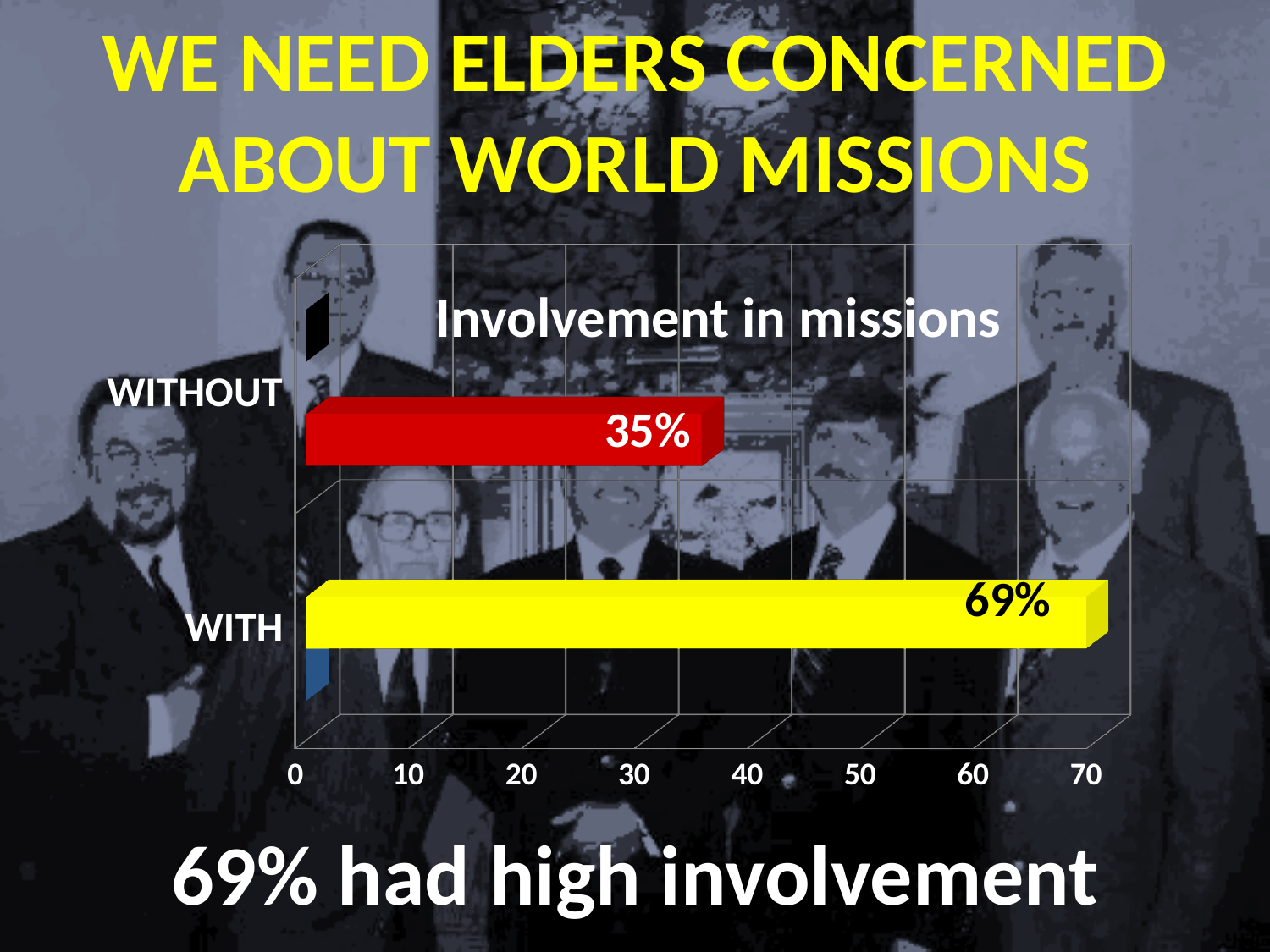
How many categories are shown in the Involvement in missions chart? 2 What kind of chart is the Involvement in missions chart? bar chart What is the value for WITH in the Involvement in missions chart? 69% Which category has the lowest value in the Involvement in missions chart? WITHOUT Is the value for WITHOUT greater or less than 40 in the Involvement in missions chart? less Which category has the highest value in the Involvement in missions chart? WITH What colour is the WITH bar in the Involvement in missions chart? yellow Which is larger in the Involvement in missions chart, the value for WITH or the value for WITHOUT? WITH Is the value for WITH greater or less than 60 in the Involvement in missions chart? greater What is the value for WITHOUT in the Involvement in missions chart? 35% What is the difference between the WITH and WITHOUT values in the Involvement in missions chart? 34% What is the title of the chart on the slide? Involvement in missions